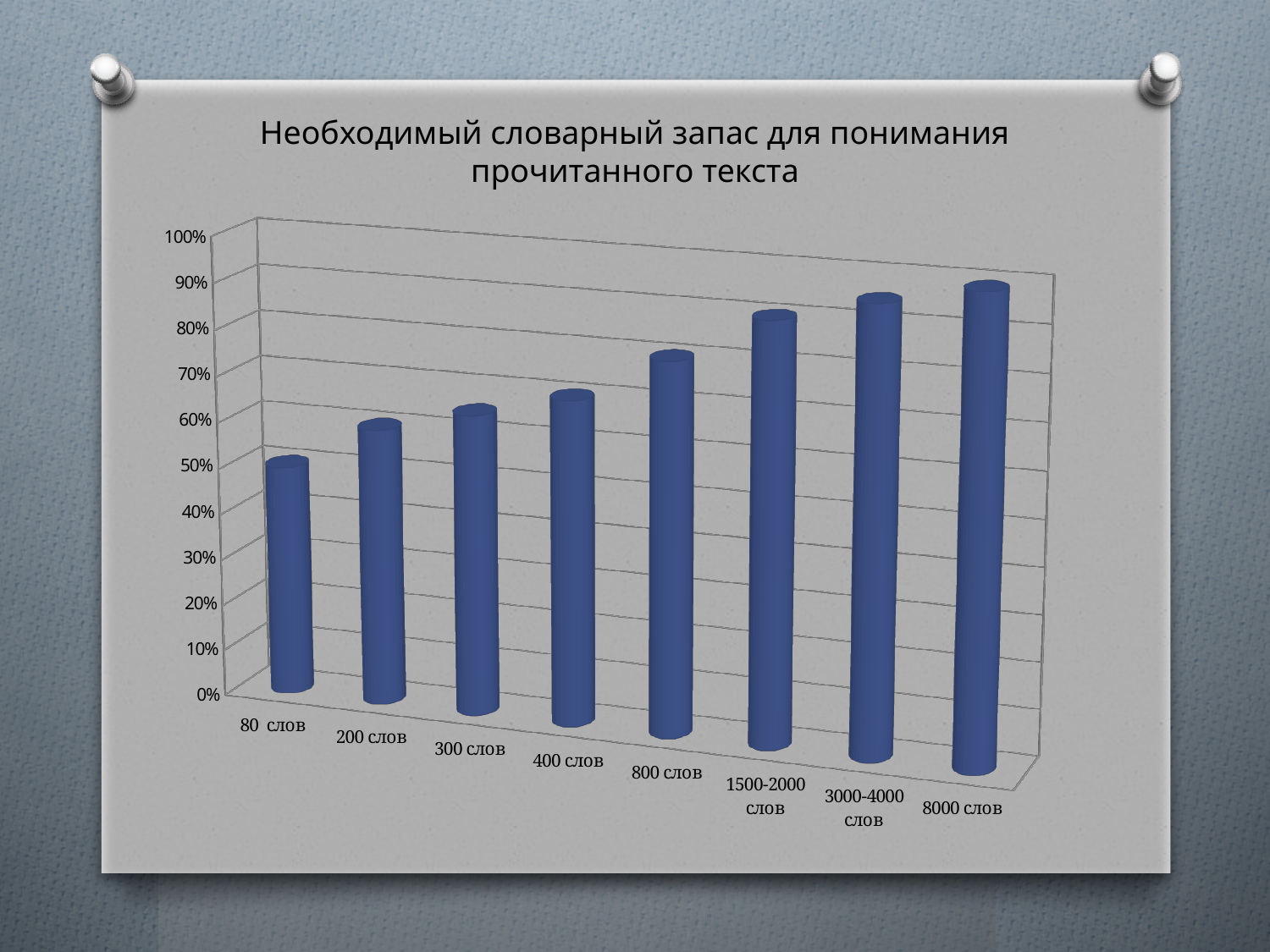
What kind of chart is shown on the slide? Bar chart Is the value for 200 слов greater or less than 80%? less Is the value for 80 слов greater or less than 70%? less Is the value for 8000 слов greater or less than 70%? greater Which category has the highest value? 8000 слов Which category has the lowest value? 80 слов What is the title of the chart? Необходимый словарный запас для понимания прочитанного текста Do the values rise or fall from left to right along the x axis? Rise How many categories are plotted on the chart? 8 Which is larger, the value for 1500-2000 слов or the value for 400 слов? 1500-2000 слов Which is larger, the value for 8000 слов or the value for 80 слов? 8000 слов